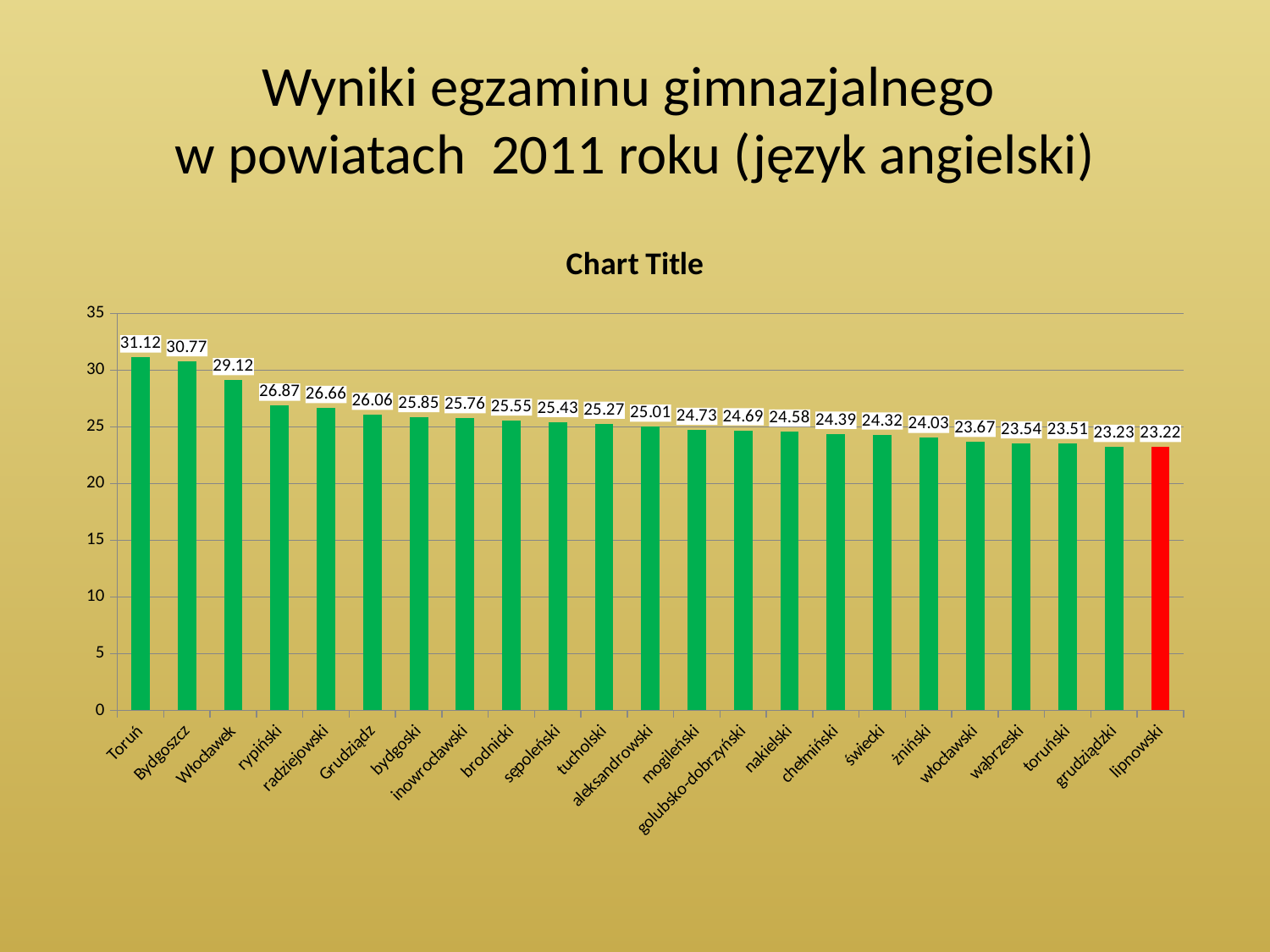
Which is larger, the value for Włocławek or the value for Grudziądz? Włocławek What is the value for lipnowski? 23.22 Which category has the highest value? Toruń What is the value for rypiński? 26.87 What is the value for Toruń? 31.12 Which category's bar is coloured red instead of green? lipnowski What is the difference between the values for Toruń and Bydgoszcz? 0.35 Which category has the lowest value? lipnowski How many categories are shown on the x axis? 23 What kind of chart is shown on the slide? bar chart What is the value for golubsko-dobrzyński? 24.69 Is the value for brodnicki greater or less than 25? greater